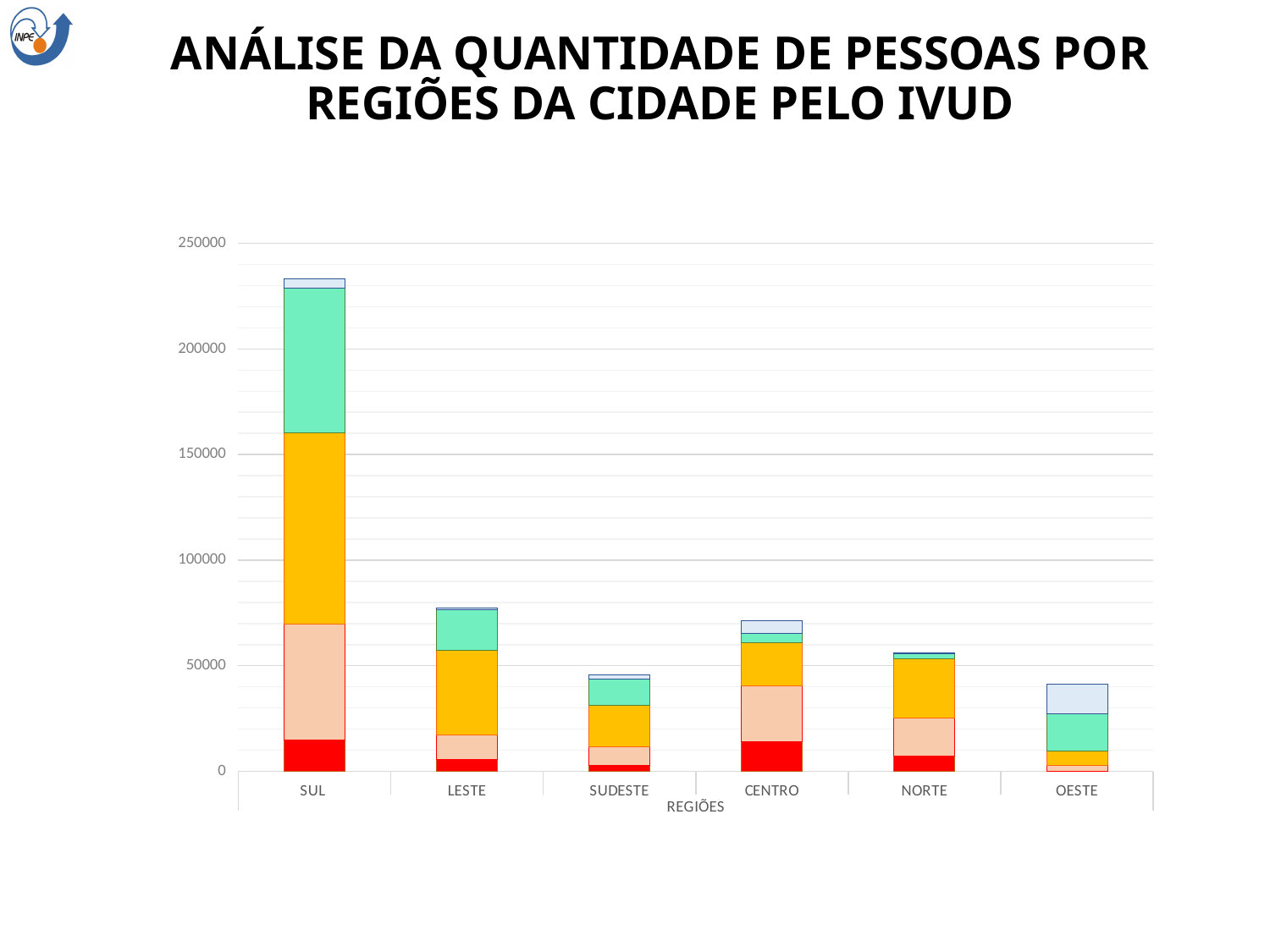
What is the title of the x axis of the chart? REGIÕES Which region has the tallest stacked bar? SUL Which has the larger total, LESTE or NORTE? LESTE Is the total value for CENTRO greater or less than 50000? greater Is the total value for OESTE greater or less than 50000? less Is the total value for LESTE greater or less than 100000? less Which has the larger total, CENTRO or OESTE? CENTRO How many regions are shown on the x axis of the chart? 6 Which has the larger total, SUL or LESTE? SUL What kind of chart is shown on the slide? stacked bar chart